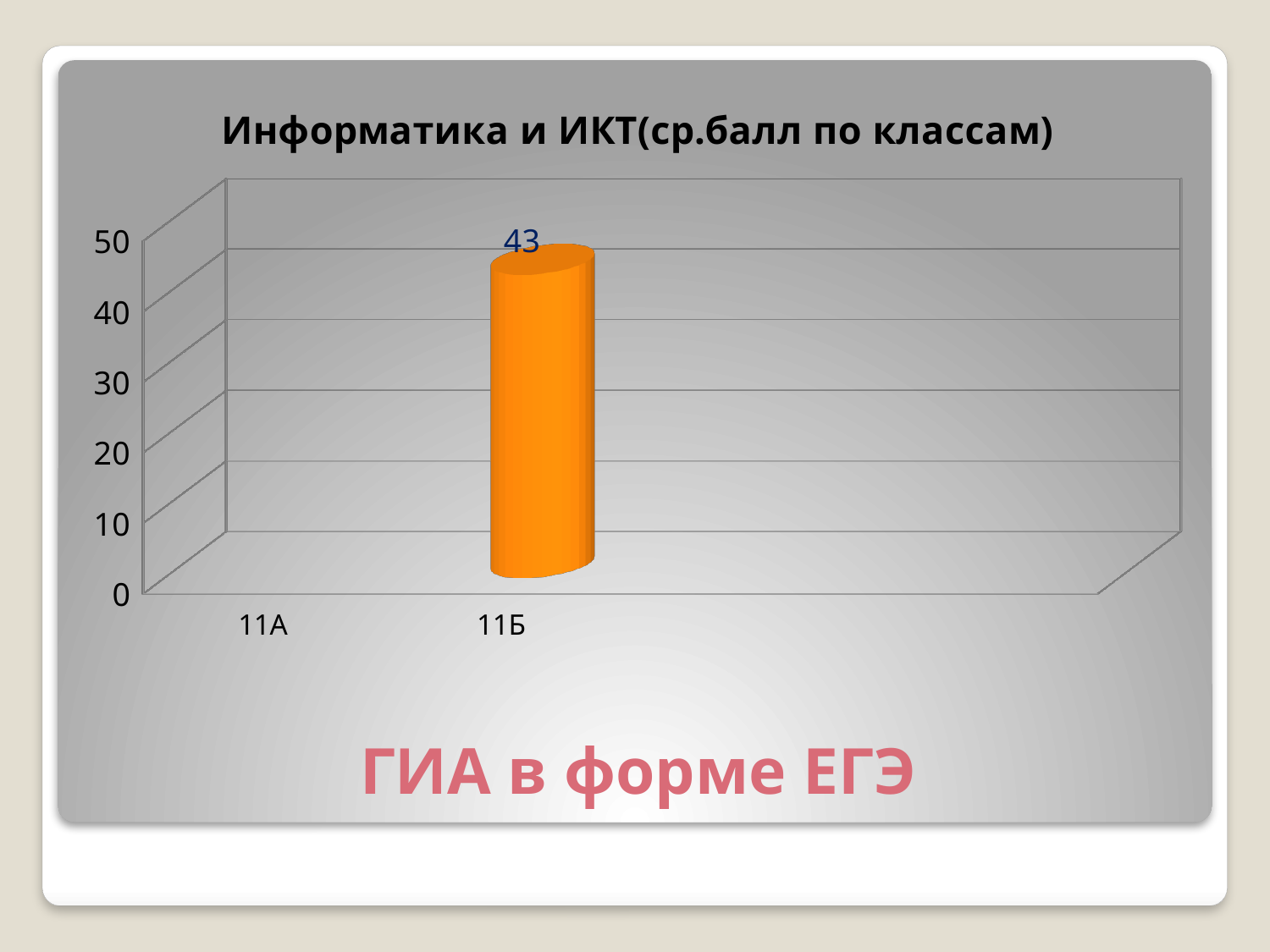
Which category has the highest value? 11Б Which category has no visible bar in the chart? 11А What is the title of the chart? Информатика и ИКТ(ср.балл по классам) What colour is the bar for 11Б? orange Is the value for 11Б greater or less than 40? greater What is the value shown for 11Б? 43 What kind of chart is shown on the slide? bar chart What is the highest tick value shown on the vertical axis? 50 Is the value for 11Б greater or less than 50? less How many categories are shown on the x axis? 2 Which category has the larger value, 11А or 11Б? 11Б